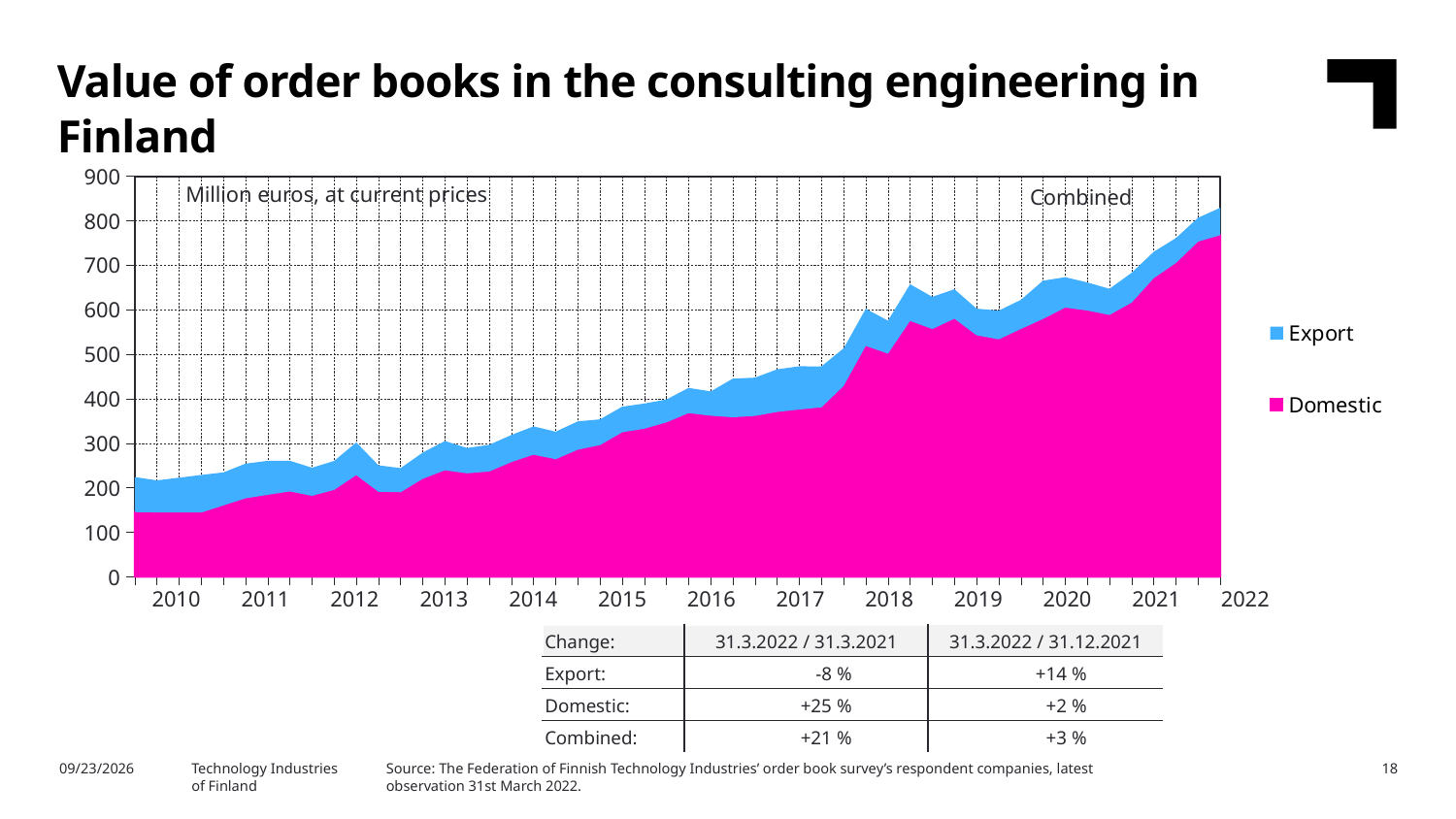
How many series does the chart legend list? 2 Is the Domestic value at the start of the series (2010) greater or less than 200? less Which two series are listed in the chart legend? Export and Domestic In what unit are the values on the chart expressed, according to the label inside the plot area? Million euros, at current prices Is the Domestic value at the start of 2016 greater or less than 400? less According to the change table below the chart, what is the Domestic change for 31.3.2022 / 31.3.2021? +25 % Is the Domestic value at the end of the series (2022) greater or less than 700? greater Which series, Export or Domestic, has the larger value at the end of the series in 2022? Domestic Do the combined order book values generally rise or fall from 2010 to 2022? Rise What kind of chart is shown on the slide? Stacked area chart